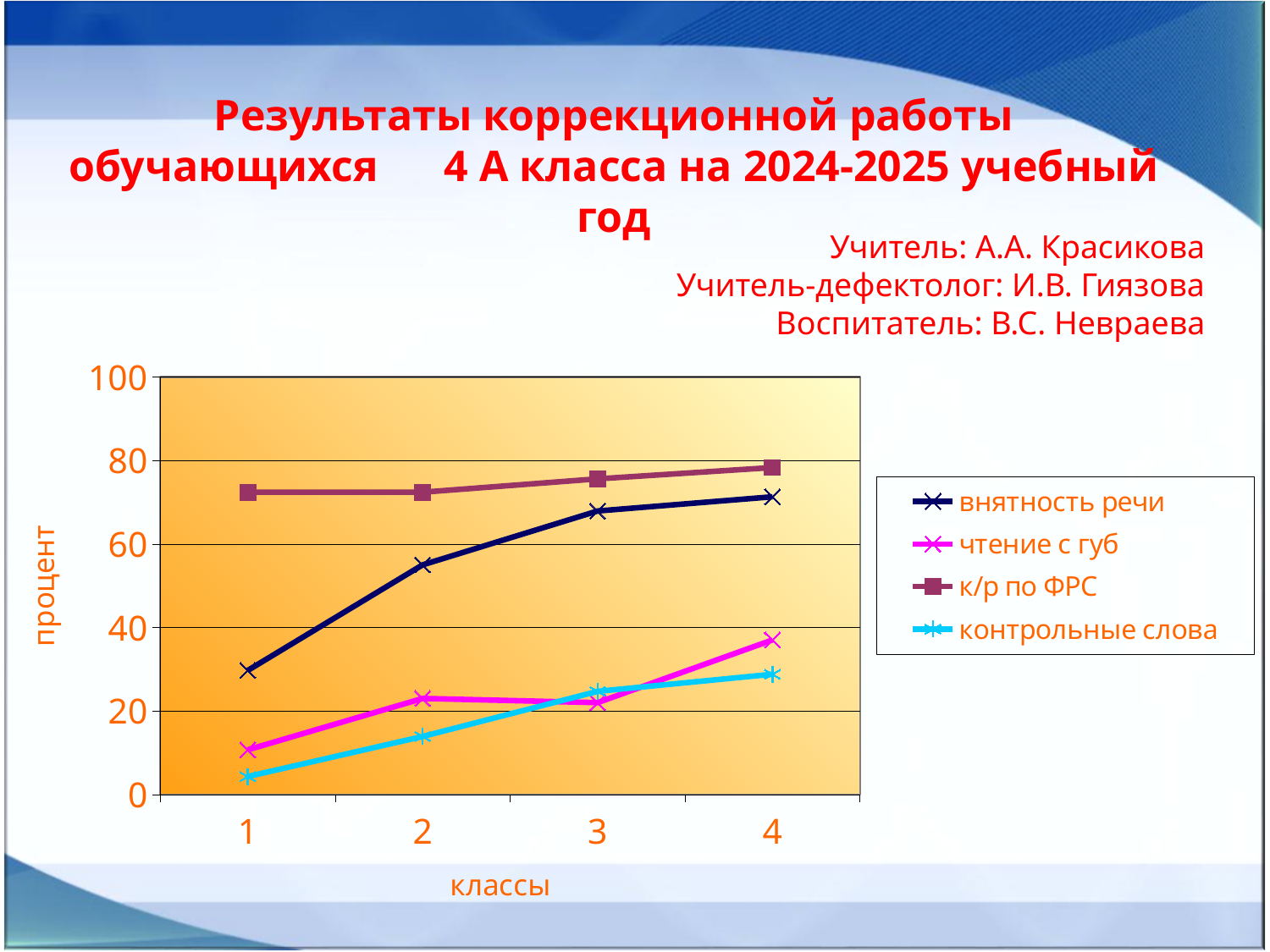
Which series has the highest value at class 1? к/р по ФРС At class 3, which is larger: внятность речи or чтение с губ? внятность речи What is the label of the vertical axis? процент Is the value for внятность речи at class 1 greater or less than 40? less Is the value for внятность речи at class 2 greater or less than 40? greater How many series does the legend list? 4 How many classes (points) are plotted along the x axis? 4 What kind of chart is shown on the slide? line chart Does the внятность речи series rise or fall from class 1 to class 4? rise Is the value for к/р по ФРС at class 4 greater or less than 80? less Which series has the lowest value at class 1? контрольные слова